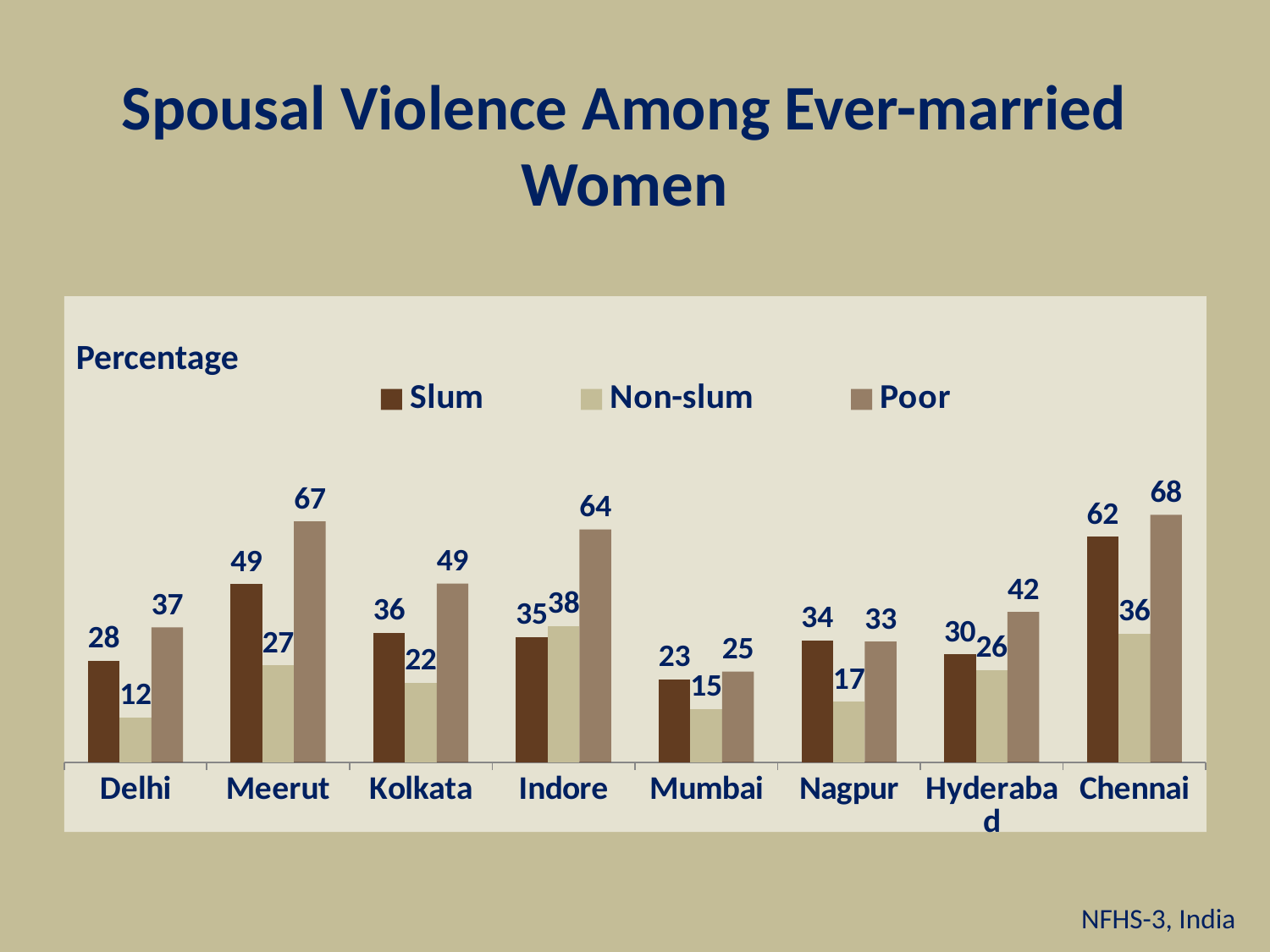
What is the Non-slum value for Chennai? 36 Which city has the lowest Non-slum value? Delhi What is the Slum value for Delhi? 28 What is the Poor value for Meerut? 67 How many series does the legend list? 3 What is the title of the chart on the slide? Spousal Violence Among Ever-married Women What is the difference between the Poor and Slum values for Indore? 29 What kind of chart is shown on the slide? Bar chart Which city has the highest Poor value? Chennai Which is larger for Nagpur, the Slum value or the Poor value? Slum What is the difference between the Slum values for Chennai and Mumbai? 39 How many cities are shown on the x axis? 8